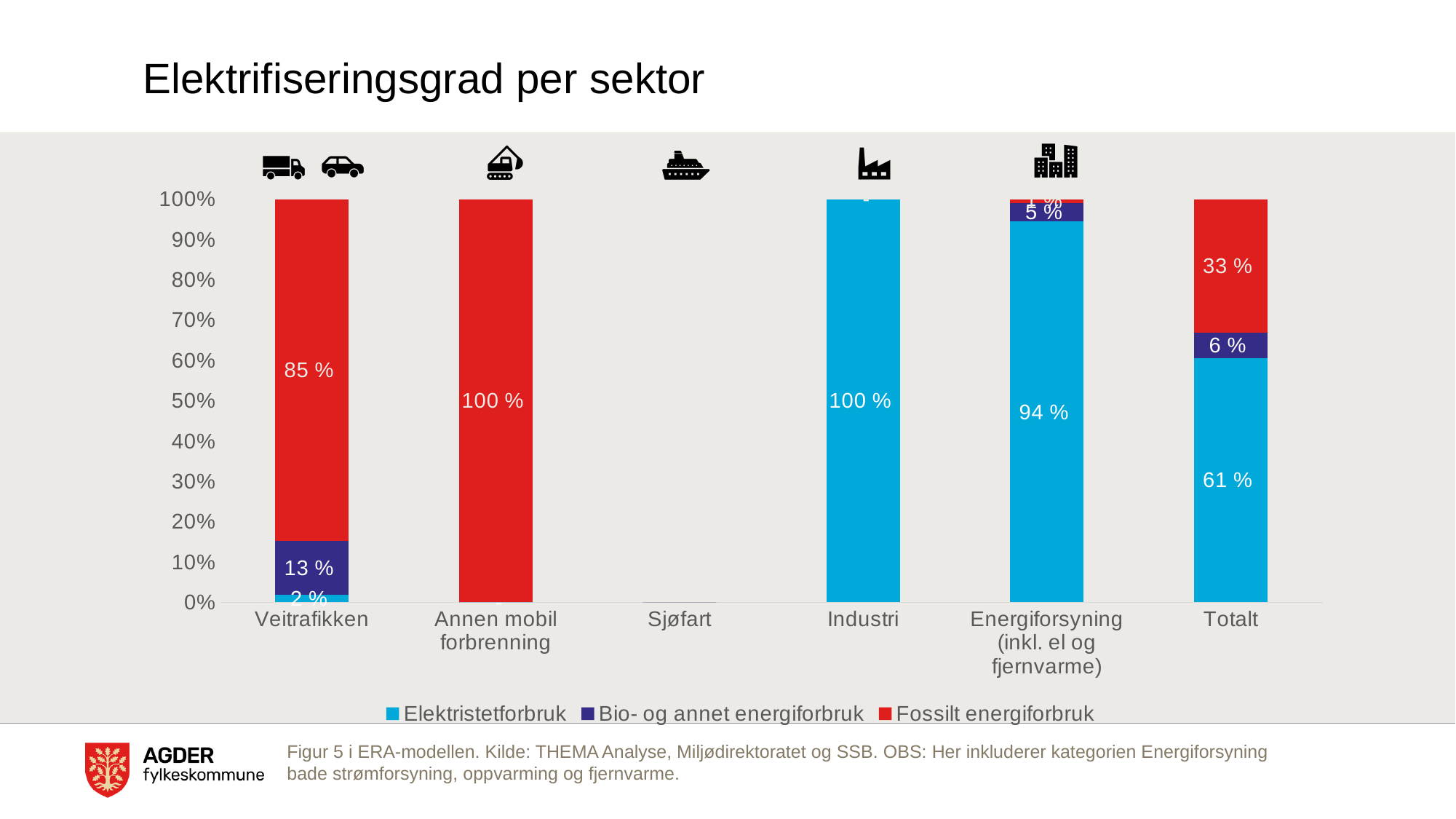
What is the Bio- og annet energiforbruk share for Veitrafikken? 13 % What is the title of the chart? Elektrifiseringsgrad per sektor Which sector has the highest Elektristetforbruk share? Industri Which is larger for Totalt: the Elektristetforbruk share or the Fossilt energiforbruk share? Elektristetforbruk How many series does the legend list? 3 What is the Elektristetforbruk share for Totalt? 61 % What kind of chart is shown on the slide? stacked bar chart What is the Fossilt energiforbruk share for Veitrafikken? 85 % What is the Fossilt energiforbruk share for Annen mobil forbrenning? 100 % How many sector categories are shown on the x axis? 6 What is the difference between the Fossilt energiforbruk share for Veitrafikken and for Totalt? 52 % What is the Elektristetforbruk share for Energiforsyning (inkl. el og fjernvarme)? 94 %